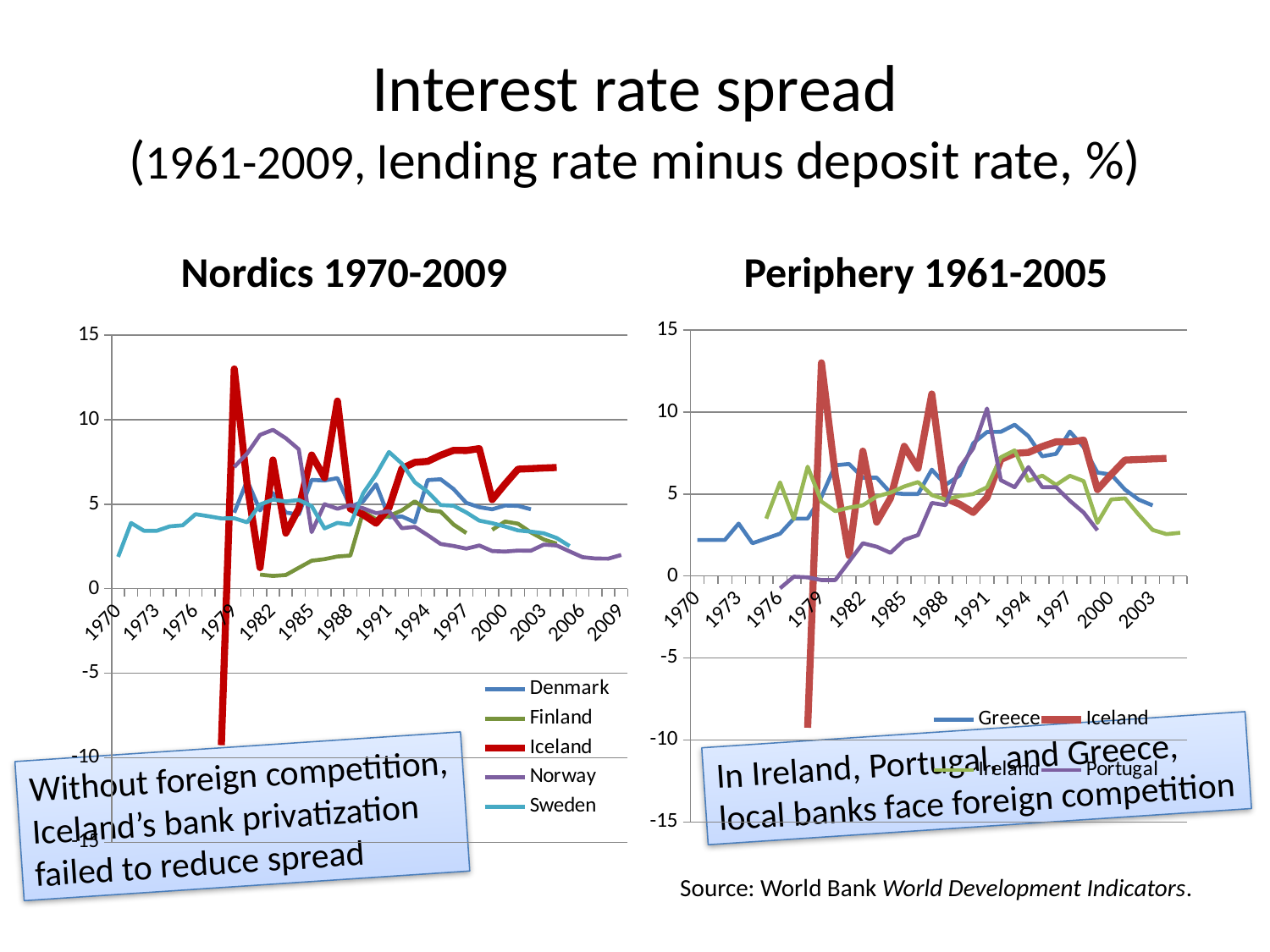
In the Nordics 1970-2009 chart, is the value for Norway in 2009 greater or less than 5? less In the Nordics 1970-2009 chart, does the Norway series rise or fall overall from 1983 to 2009? fall How many series does the legend of the Periphery 1961-2005 chart list? 4 In the Periphery 1961-2005 chart, is the value for Greece in 1970 greater or less than 5? less In the Nordics 1970-2009 chart, is the value for Sweden in 1970 greater or less than 5? less Which series appears in the legends of both charts? Iceland How many series does the legend of the Nordics 1970-2009 chart list? 5 In the Periphery 1961-2005 chart, which series reaches the highest value? Iceland In the Nordics 1970-2009 chart, which series reaches the highest value? Iceland What kind of chart is the Nordics 1970-2009 chart? line chart